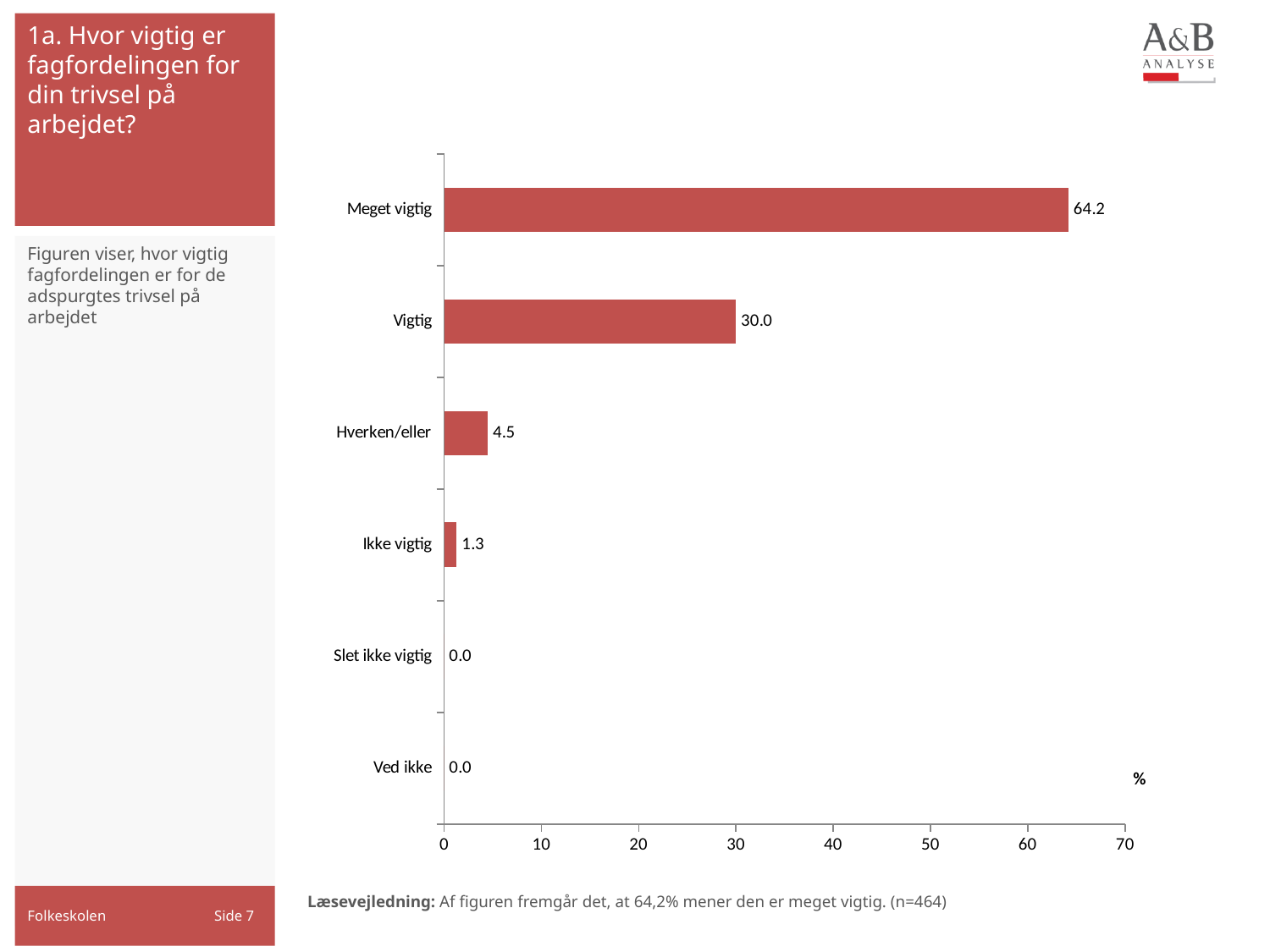
What is the difference between the values for Vigtig and Hverken/eller? 25.5 Which category has the highest value? Meget vigtig How many categories are shown on the chart? 6 Is the value for Meget vigtig greater or less than 60? greater What is the value for Vigtig? 30.0 What is the value for Slet ikke vigtig? 0.0 What is the value for Ikke vigtig? 1.3 Which is larger, the value for Hverken/eller or the value for Ikke vigtig? Hverken/eller What is the value for Hverken/eller? 4.5 What is the value for Meget vigtig? 64.2 What kind of chart is shown on the slide? bar chart What is the difference between the values for Meget vigtig and Vigtig? 34.2